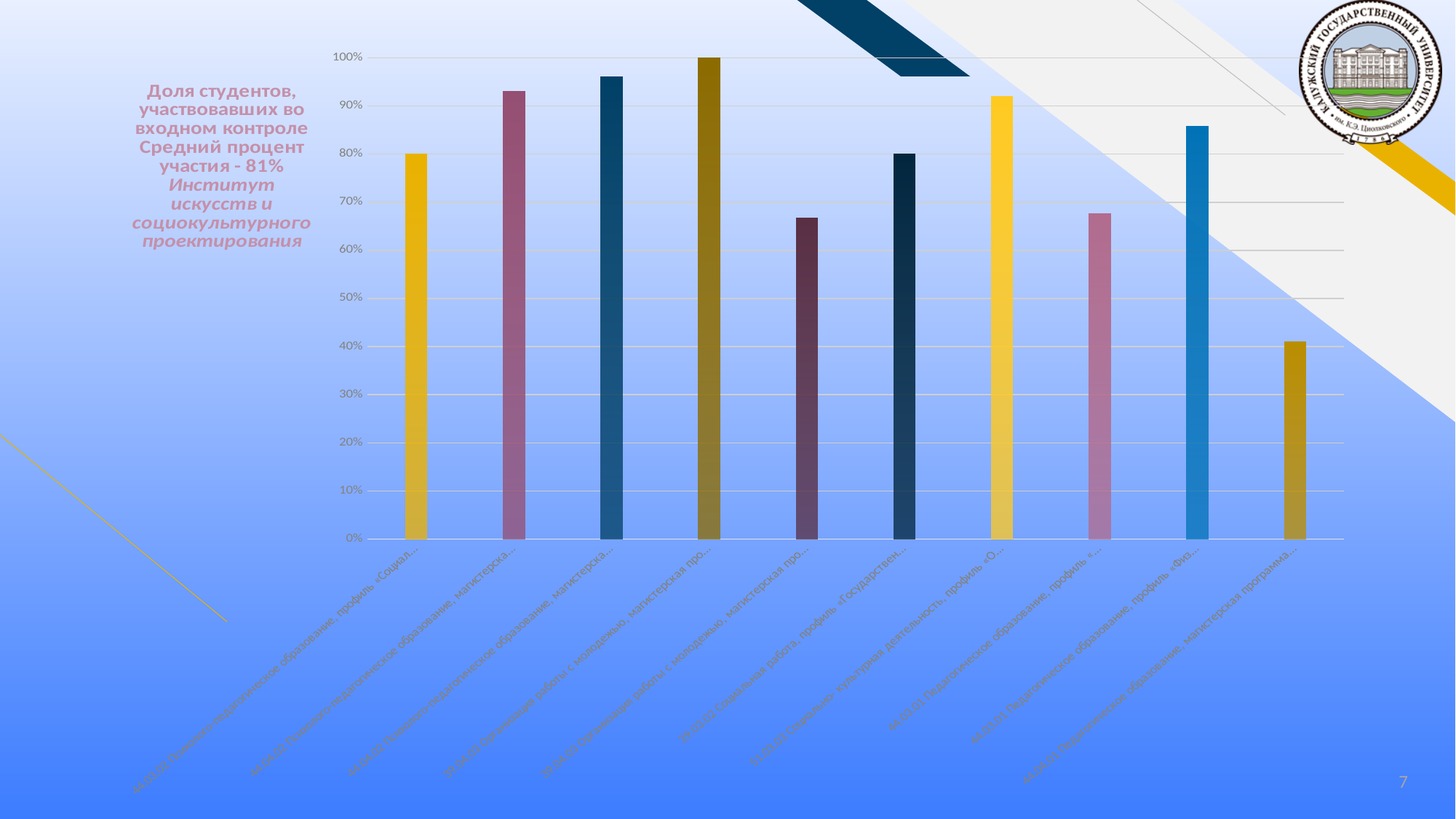
According to the text next to the chart, what is the average participation percentage? 81% Which institute does the chart refer to, according to the text next to it? Институт искусств и социокультурного проектирования Which bar has the lowest value in the chart? the rightmost bar (44.04.01 Педагогическое образование, магистерская программа...) Is the value of the third bar from the left greater or less than 90%? greater What is the value of the fourth bar from the left in the chart? 100% What kind of chart is shown on the slide? bar chart Is the value of the fifth bar from the left greater or less than 60%? greater Which is larger: the second bar from the left or the fifth bar from the left? the second bar from the left Is the value of the rightmost bar greater or less than 50%? less Which is larger: the ninth bar from the left or the tenth bar from the left? the ninth bar from the left Which bar has the highest value in the chart? the fourth bar from the left (39.04.03 Организация работы с молодежью, магистерская про...) How many bars (categories) does the chart contain? 10